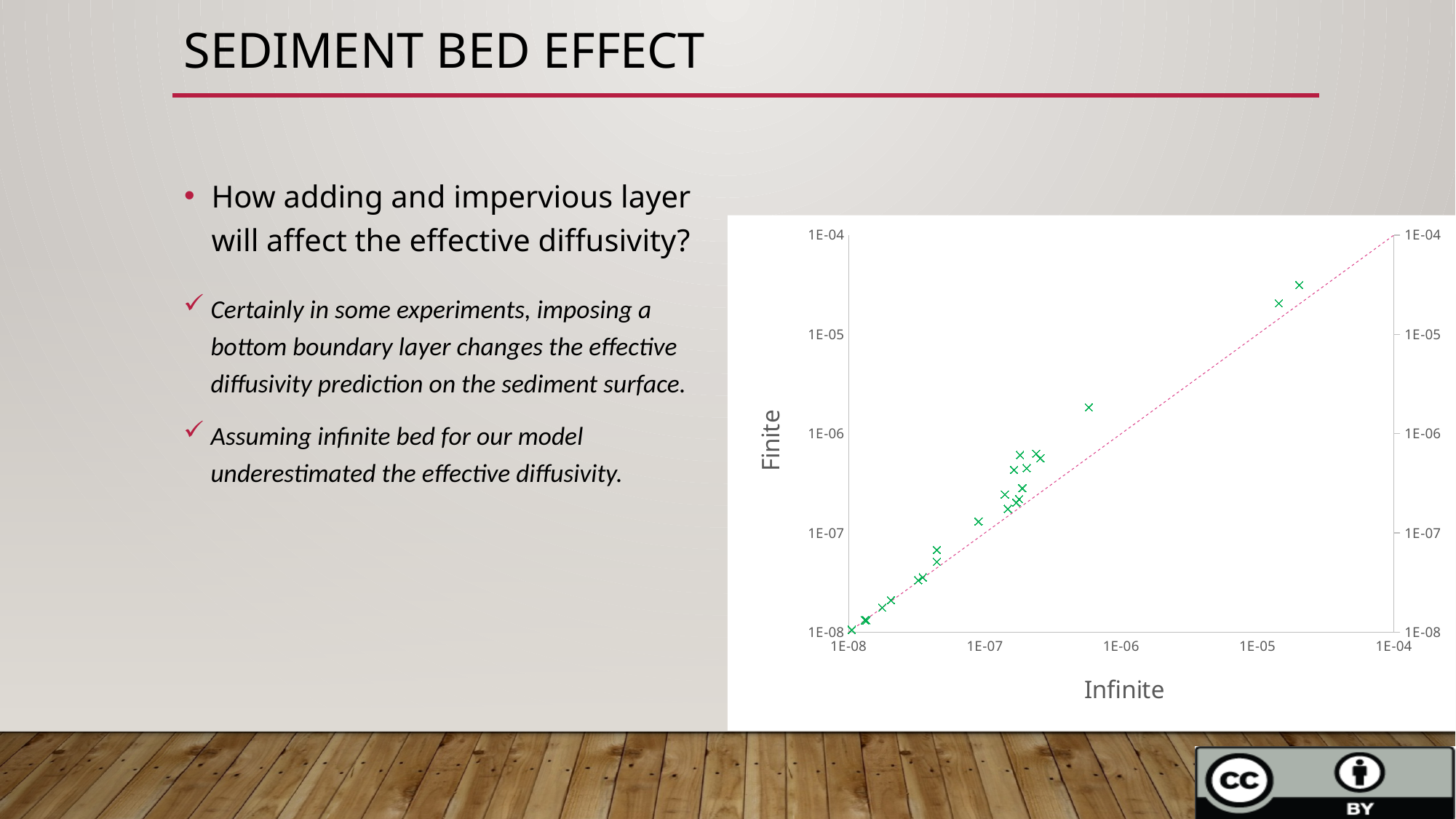
Is the Infinite value of the lowest plotted point greater or less than 1E-07? less What is the lowest tick value shown on the horizontal (Infinite) axis? 1E-08 What is the highest tick value shown on the vertical (Finite) axis? 1E-04 How many tick labels are shown along the horizontal (Infinite) axis? 5 Which has the larger Finite value: the point with the largest Infinite value, or the isolated point plotted between Infinite = 1E-07 and 1E-06? the point with the largest Infinite value What is the label of the vertical axis of the chart? Finite Is the Finite value of the point with the largest Infinite value greater or less than 1E-05? greater As the Infinite value increases along the x axis, do the plotted Finite values generally rise or fall? rise Is the Finite value of the isolated point plotted between Infinite = 1E-07 and 1E-06 greater or less than 1E-06? greater What is the label of the horizontal axis of the chart? Infinite What kind of chart is shown on the slide? scatter chart